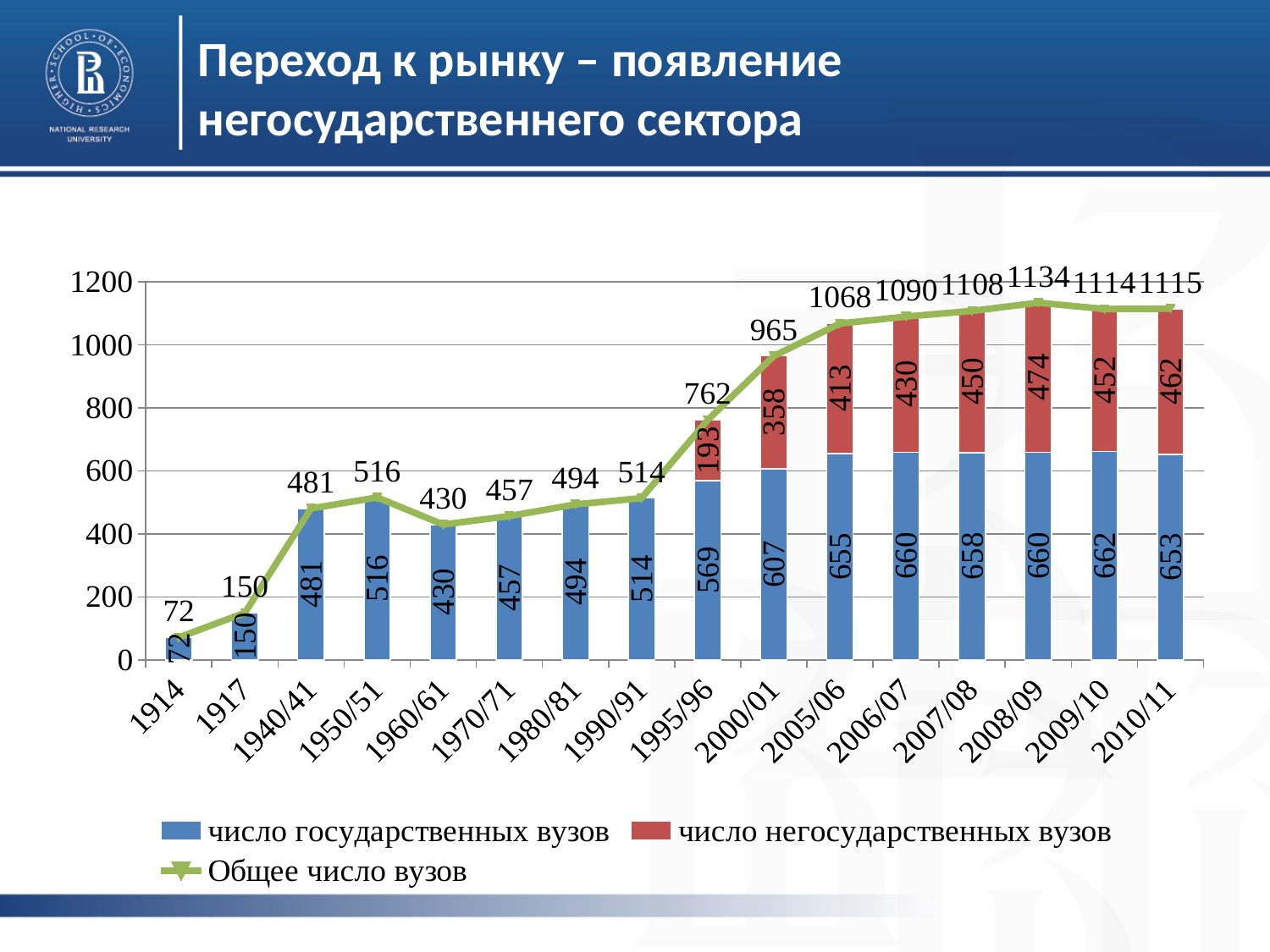
Does the total number of universities rise or fall from 1995/96 to 2008/09? Rise Which is larger: the number of state universities in 1950/51 or in 1960/61? 1950/51 How many state universities (число государственных вузов) are shown for 2000/01? 607 How many series does the legend list? 3 What is the total number of universities (Общее число вузов) shown for 2005/06? 1068 In which year is the total number of universities the highest? 2008/09 What is the total of the stacked bar for 2007/08? 1108 Which category has the lowest number of state universities? 1914 What kind of chart is shown on the slide? Stacked bar chart with a line What is the difference between the number of non-state universities in 2010/11 and in 1995/96? 269 How many categories are shown on the x axis? 16 What is the number of non-state universities (число негосударственных вузов) in 2008/09? 474